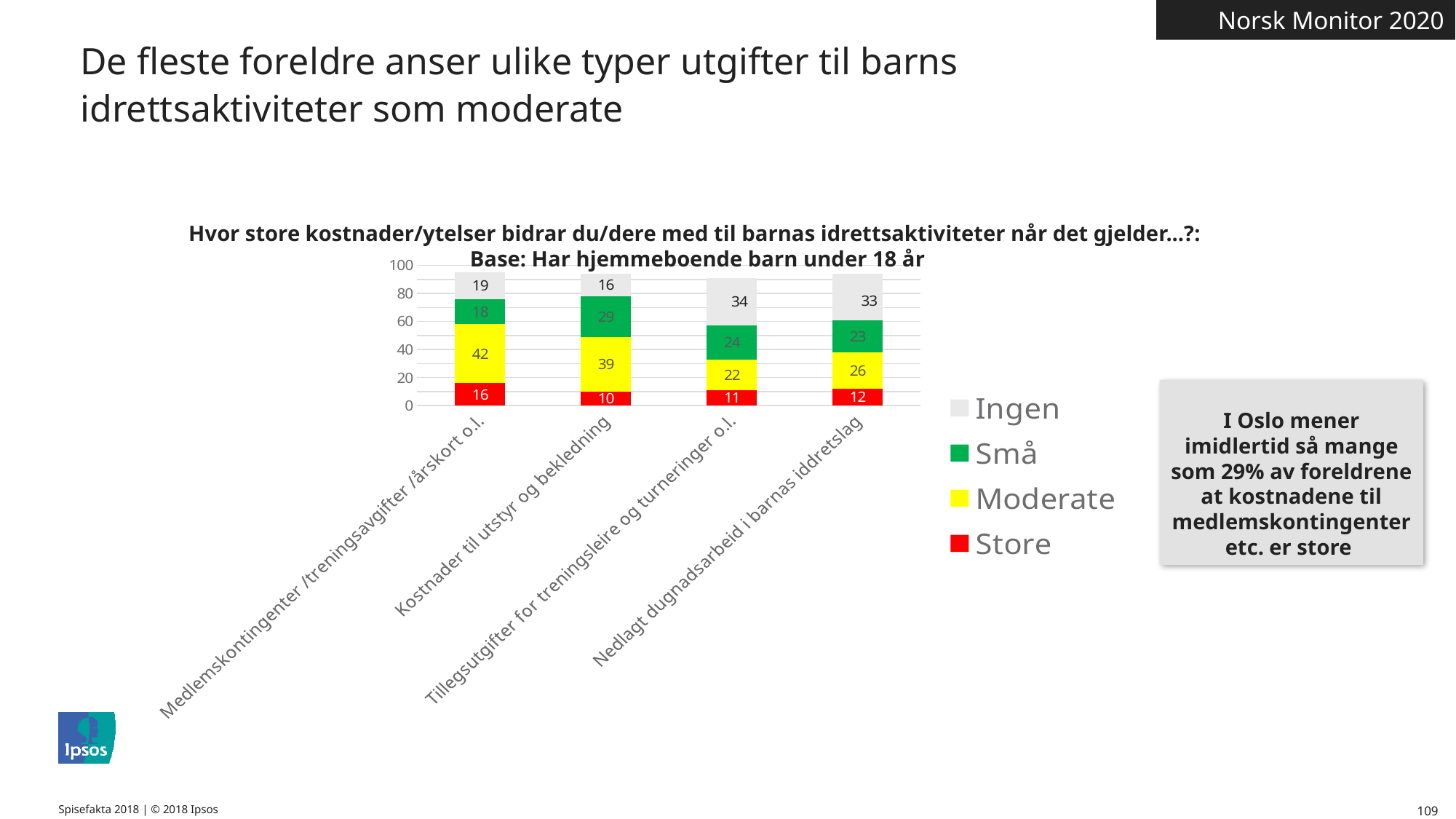
What is the 'Moderate' value for 'Medlemskontingenter /treningsavgifter /årskort o.l.'? 42 How many series does the legend list? 4 How many categories are shown on the x axis? 4 What is the 'Små' value for 'Kostnader til utstyr og bekledning'? 29 What is the 'Ingen' value for 'Tillegsutgifter for treningsleire og turneringer o.l.'? 34 What is the total of the stacked bar for 'Kostnader til utstyr og bekledning'? 94 Which category has the lowest 'Moderate' value? Tillegsutgifter for treningsleire og turneringer o.l. What is the difference between the 'Moderate' values for 'Medlemskontingenter /treningsavgifter /årskort o.l.' and 'Kostnader til utstyr og bekledning'? 3 Which is larger: the 'Ingen' value for 'Tillegsutgifter for treningsleire og turneringer o.l.' or for 'Medlemskontingenter /treningsavgifter /årskort o.l.'? Tillegsutgifter for treningsleire og turneringer o.l. Which category has the highest 'Store' value? Medlemskontingenter /treningsavgifter /årskort o.l. What is the 'Store' value for 'Nedlagt dugnadsarbeid i barnas idrettslag'? 12 What kind of chart is shown on the slide? Stacked bar chart